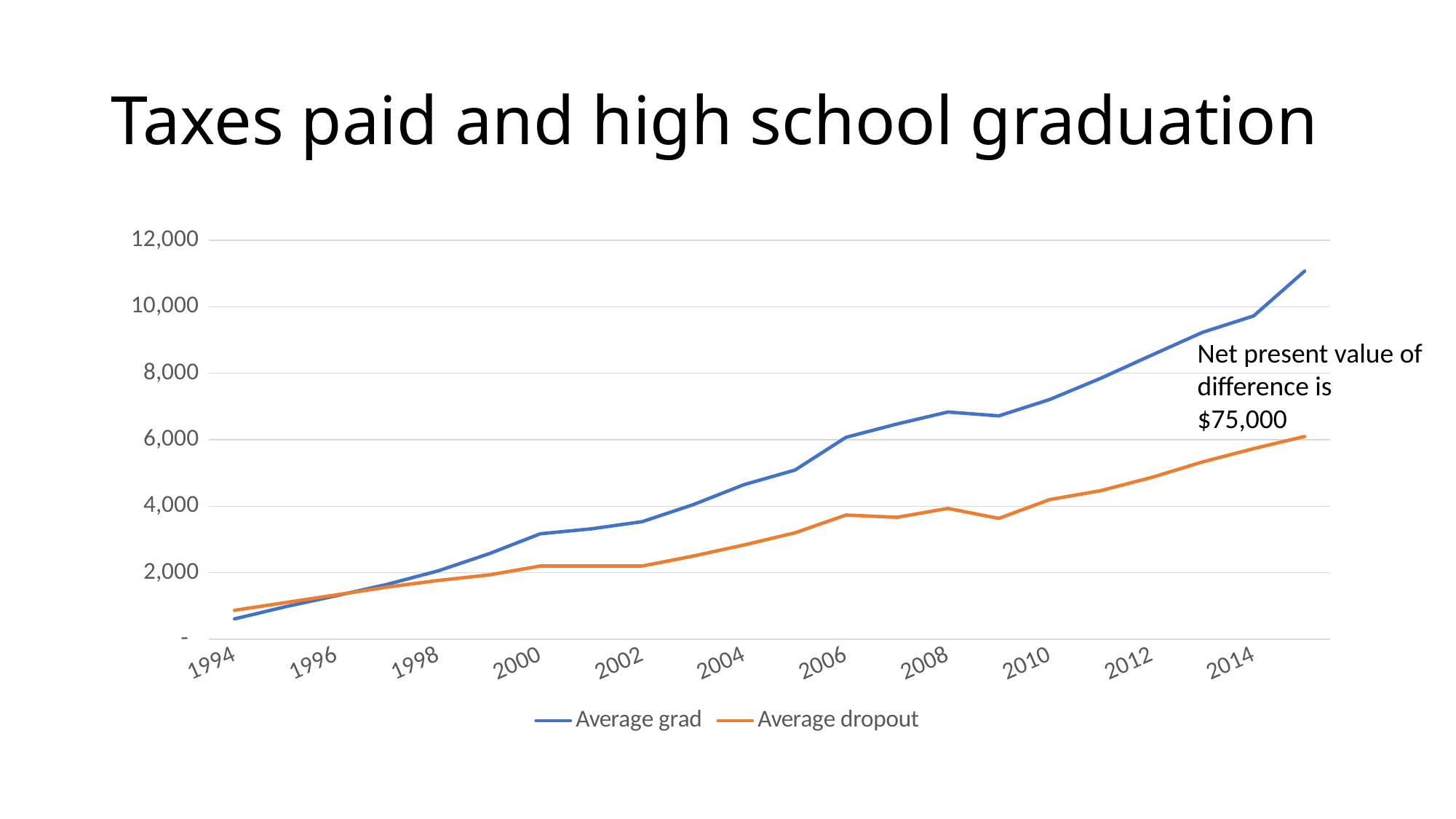
What is the title of the slide? Taxes paid and high school graduation Is the value for Average grad in 2014 greater or less than 8,000? greater How many year labels are shown on the x axis? 11 What are the two series named in the legend? Average grad and Average dropout How many series does the legend list? 2 Does the Average dropout line rise or fall overall from 1994 to 2014? Rise What kind of chart is shown on the slide? Line chart Is the value for Average grad in 2010 greater or less than 6,000? greater Is the value for Average dropout in 2004 greater or less than 4,000? less Does the Average grad line rise or fall overall from 1994 to 2014? Rise In 2012, which series has the higher value, Average grad or Average dropout? Average grad